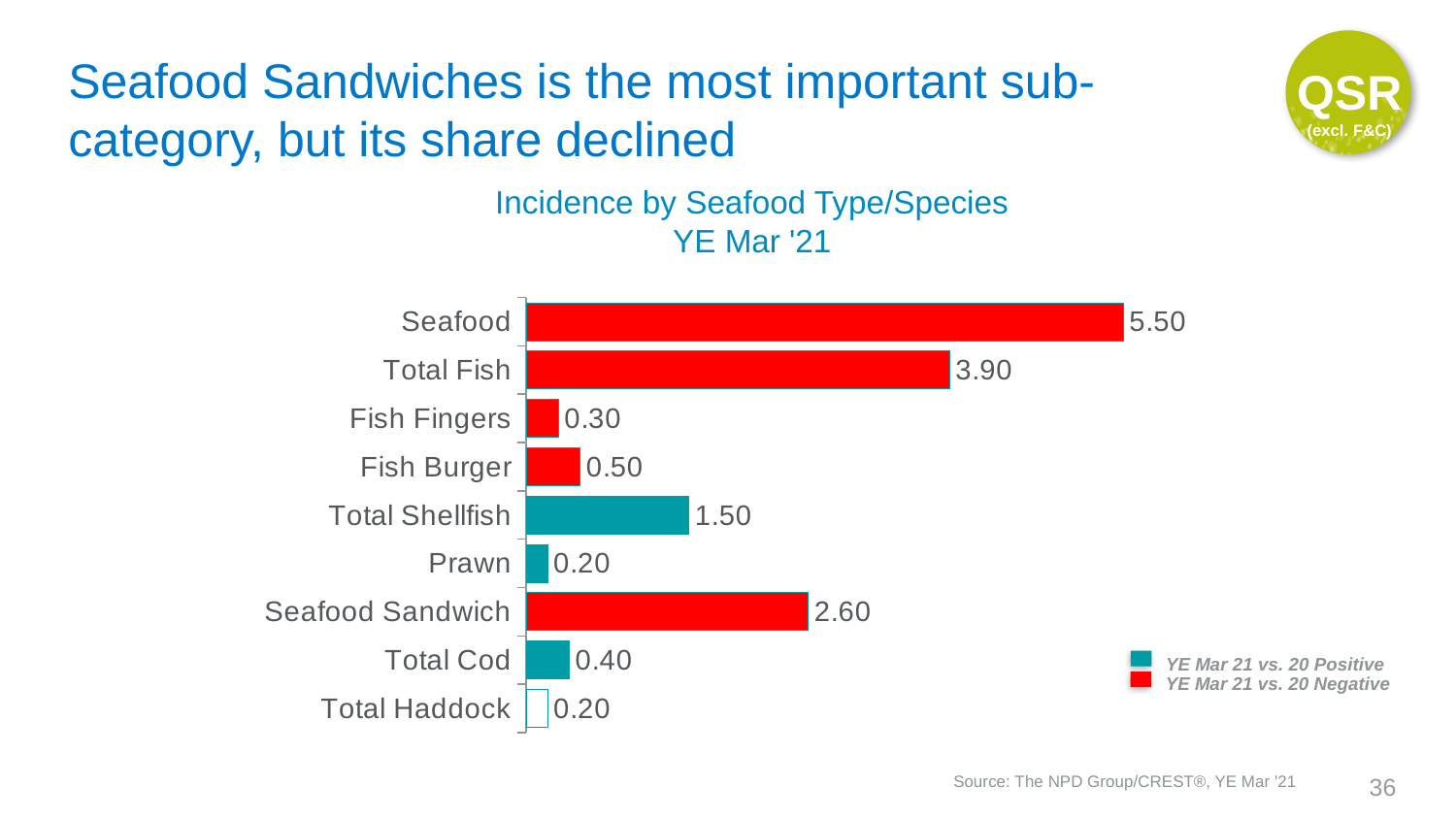
How many entries does the legend list? 2 How many categories are shown in the chart? 9 Which category has the highest value? Seafood What type of chart is shown on the slide? Bar chart What is the value for Fish Burger? 0.50 What is the value for Seafood Sandwich? 2.60 What is the value for Total Shellfish? 1.50 What is the difference between the values for Seafood Sandwich and Total Shellfish? 1.10 Which has a larger value, Total Fish or Seafood Sandwich? Total Fish What is the value for Seafood? 5.50 What is the difference between the values for Seafood and Total Fish? 1.60 Which has a larger value, Total Cod or Fish Fingers? Total Cod